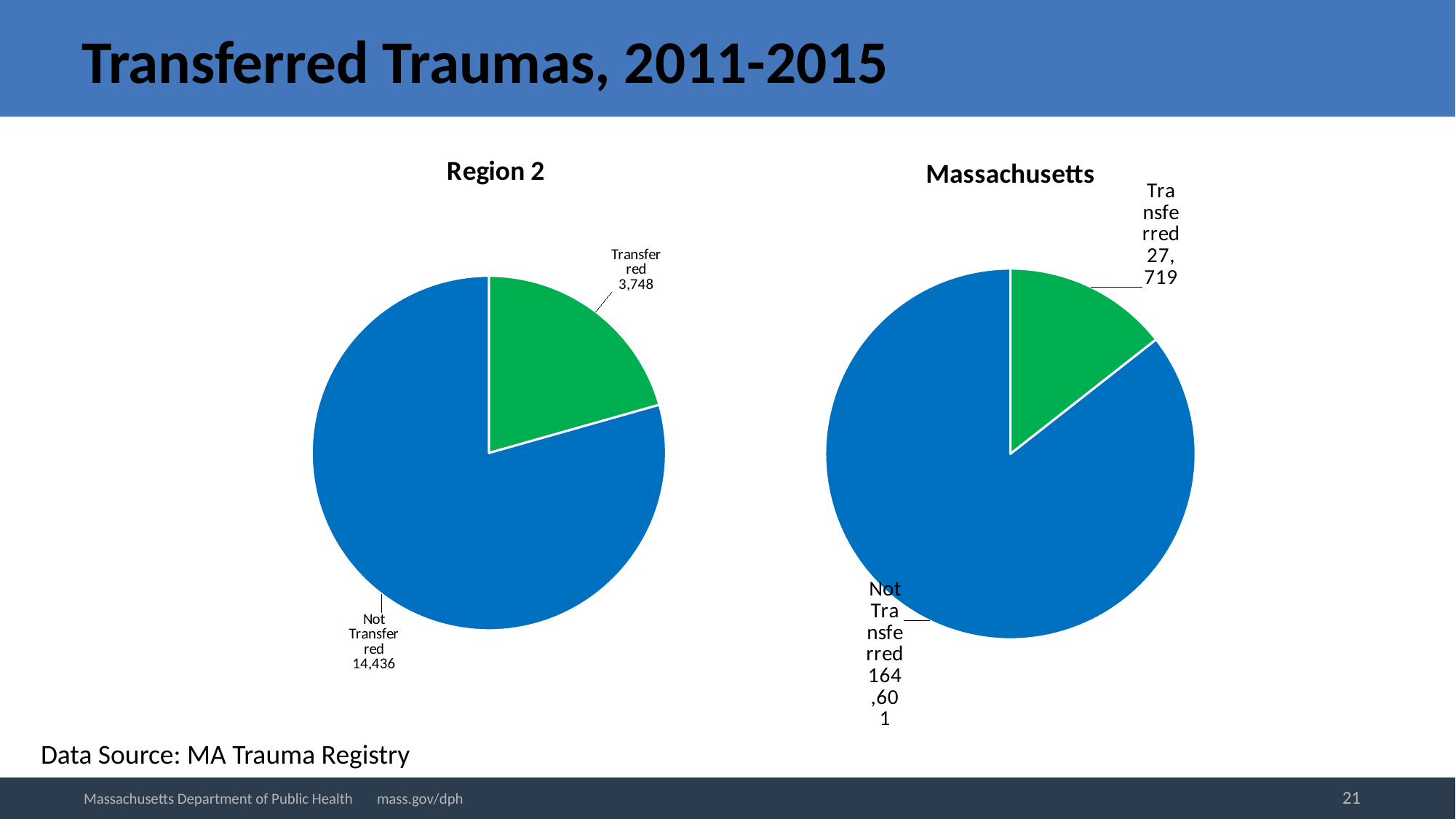
In the Massachusetts chart, how many traumas were Not Transferred? 164,601 In the Region 2 chart, what is the difference between Not Transferred and Transferred traumas? 10,688 In the Massachusetts chart, how many traumas were Transferred? 27,719 In the Region 2 chart, what is the total number of traumas across both slices? 18,184 What colour is the Transferred slice in both pie charts? Green In the Region 2 chart, which slice is larger, Transferred or Not Transferred? Not Transferred In the Massachusetts chart, which category has the smallest slice? Transferred In the Region 2 chart, how many traumas were Not Transferred? 14,436 In the Region 2 chart, how many traumas were Transferred? 3,748 What kind of charts are shown on the slide? Pie charts How many slices does the Massachusetts pie chart have? 2 In the Massachusetts chart, what is the difference between Not Transferred and Transferred traumas? 136,882